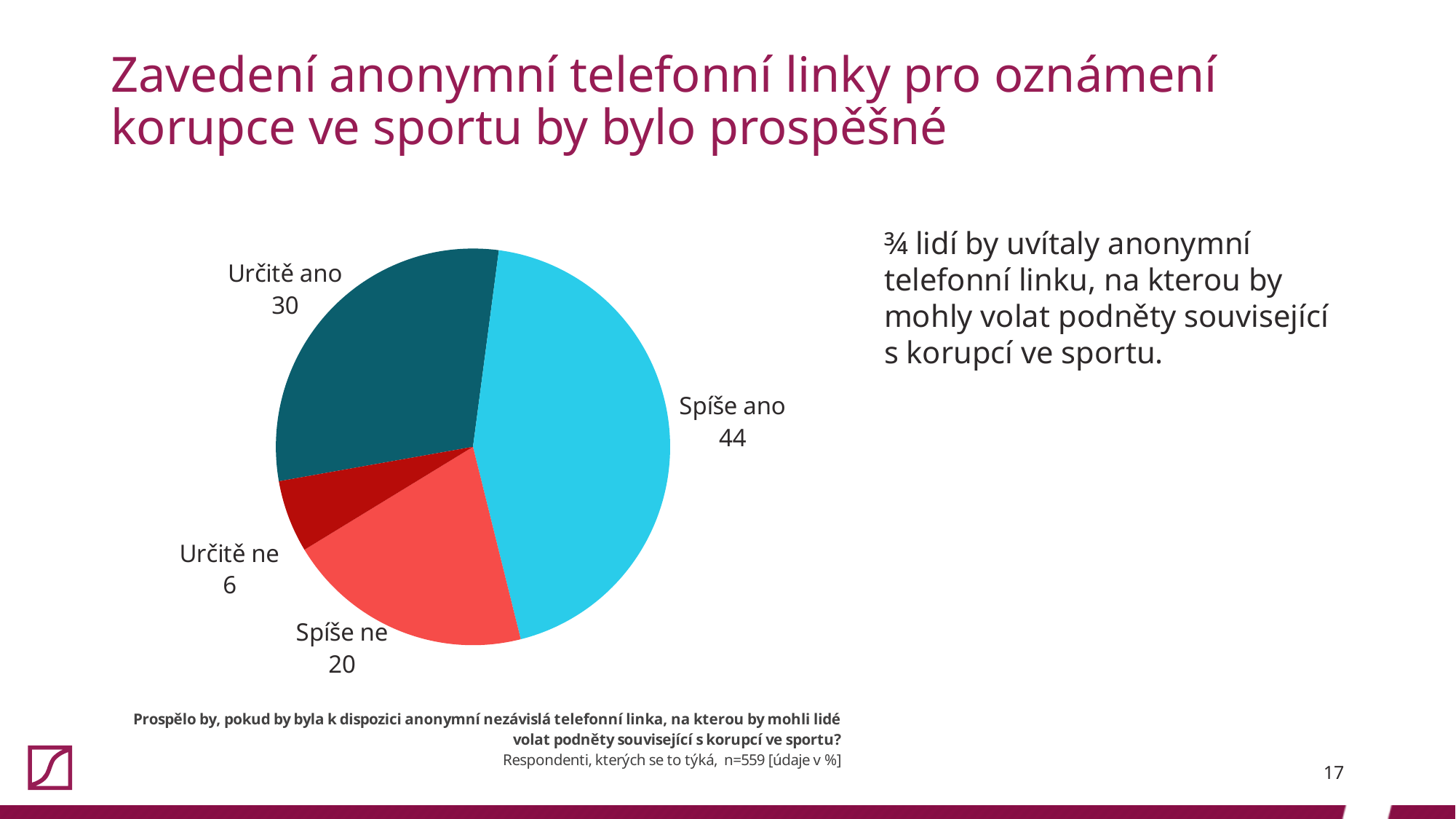
What is the value for "Spíše ne"? 20 What is the combined value of "Určitě ano" and "Spíše ano"? 74 What is the value for "Určitě ano"? 30 What colour is the "Spíše ano" slice? light blue What kind of chart is shown on the slide? pie chart Which is larger, the value for "Spíše ne" or the value for "Určitě ne"? Spíše ne What is the difference between the values for "Spíše ano" and "Určitě ano"? 14 Which category has the largest slice? Spíše ano What is the value for "Spíše ano"? 44 How many categories does the pie chart have? 4 What is the value for "Určitě ne"? 6 Which category has the smallest slice? Určitě ne